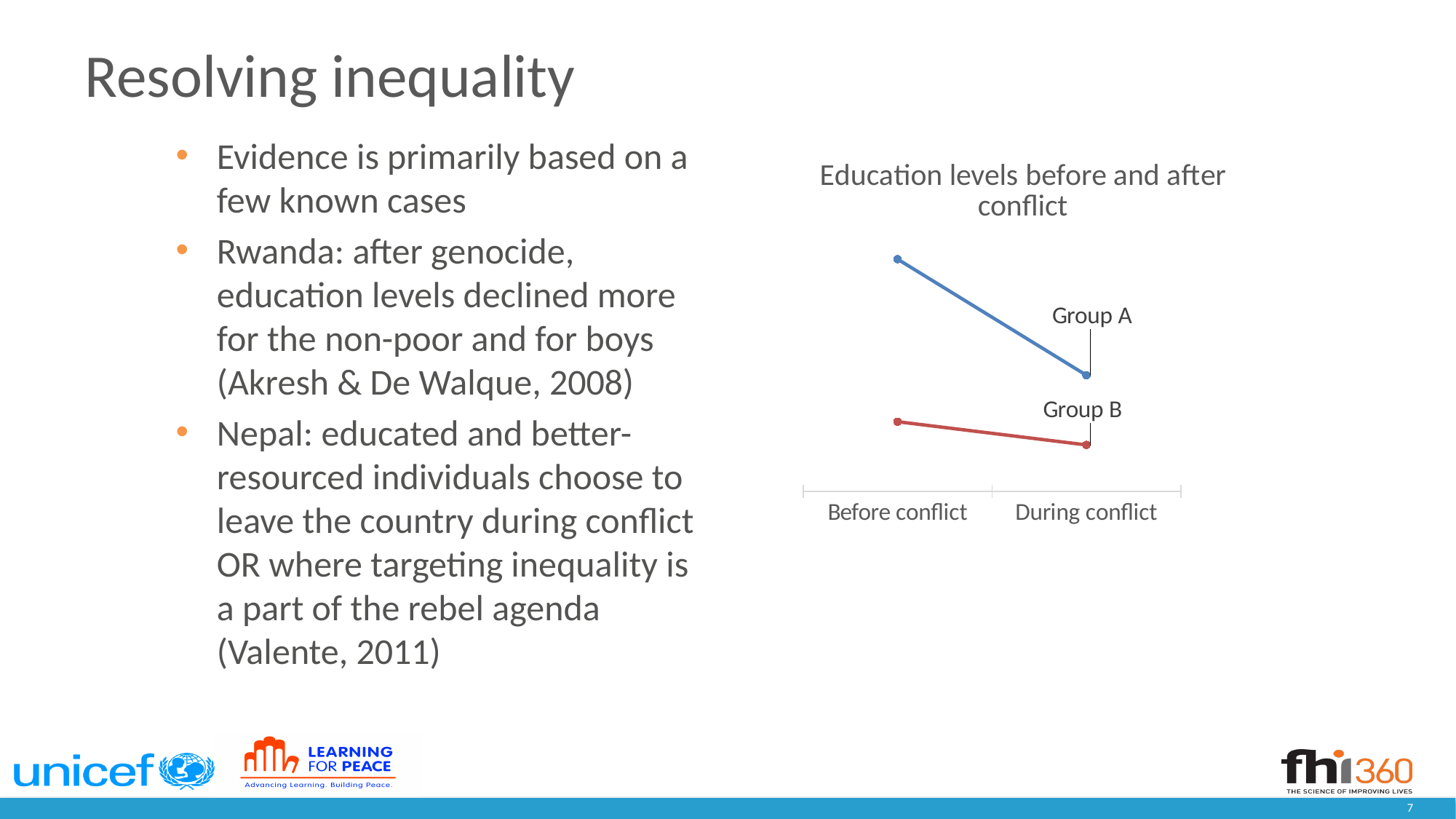
What is the title of the chart? Education levels before and after conflict Does the education level for Group B rise or fall from before conflict to during conflict? Fall Which group has the higher education level during conflict, Group A or Group B? Group A Which group shows the larger decline in education level from before conflict to during conflict? Group A What kind of chart is shown on the slide? Line chart What are the two categories on the x axis of the chart? Before conflict, During conflict Does the education level for Group A rise or fall from before conflict to during conflict? Fall How many categories are shown on the x axis of the chart? 2 Which group has the lowest education level during conflict? Group B How many series (groups) are plotted in the chart? 2 Which group has the higher education level before conflict, Group A or Group B? Group A